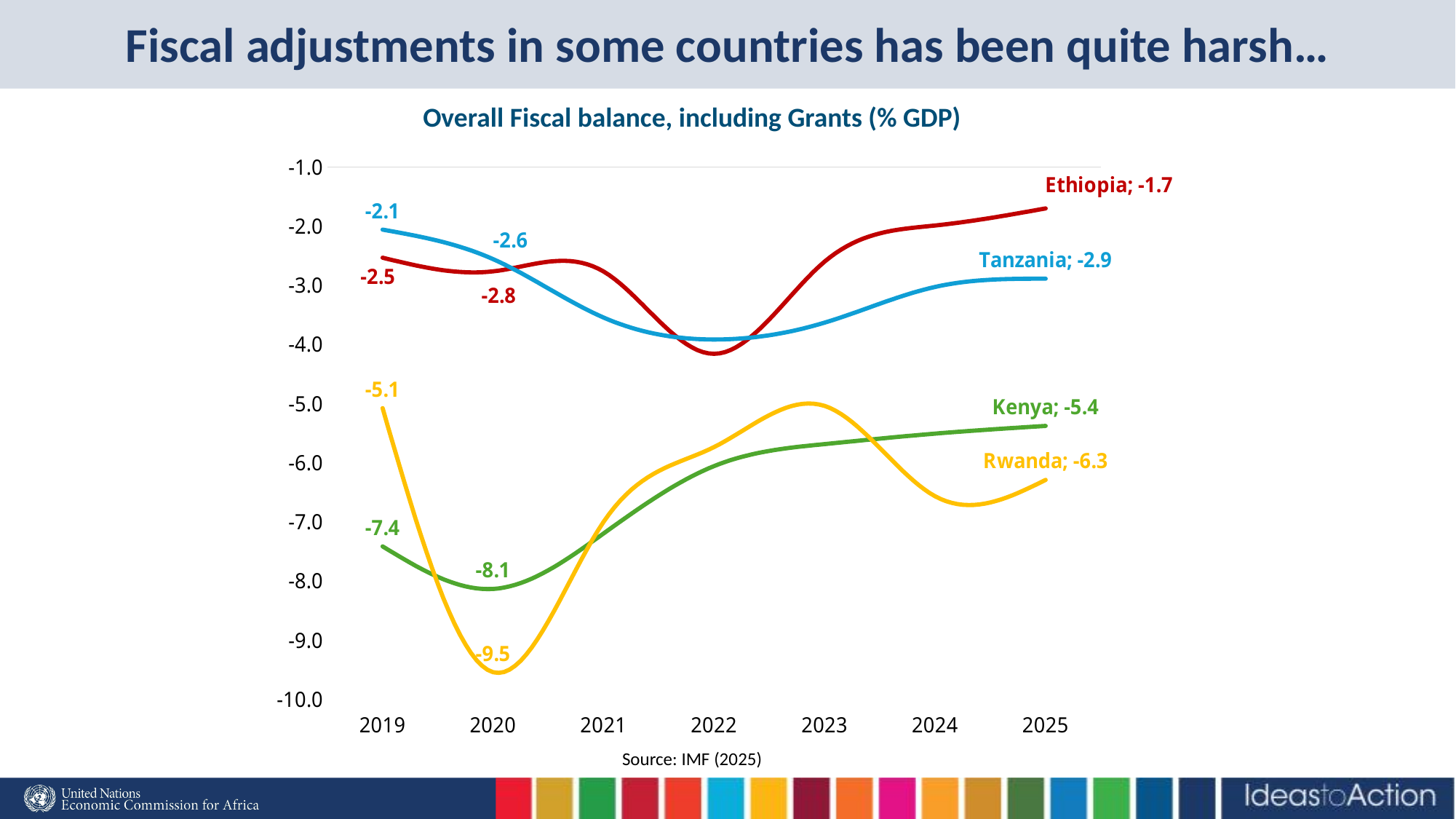
What is Tanzania's overall fiscal balance in 2025? -2.9 Which country has the lowest overall fiscal balance in 2020? Rwanda Which is larger in 2019, Tanzania's or Ethiopia's overall fiscal balance? Tanzania By how much did Rwanda's overall fiscal balance change from 2019 to 2020? -4.4 What type of chart is shown on the slide? line chart Which country has the highest overall fiscal balance in 2025? Ethiopia How many years are shown on the x axis? 7 What is Ethiopia's overall fiscal balance in 2025? -1.7 How many countries are plotted on the chart? 4 What is the title of the chart? Overall Fiscal balance, including Grants (% GDP) What is Rwanda's overall fiscal balance in 2020? -9.5 What is Kenya's overall fiscal balance in 2019? -7.4